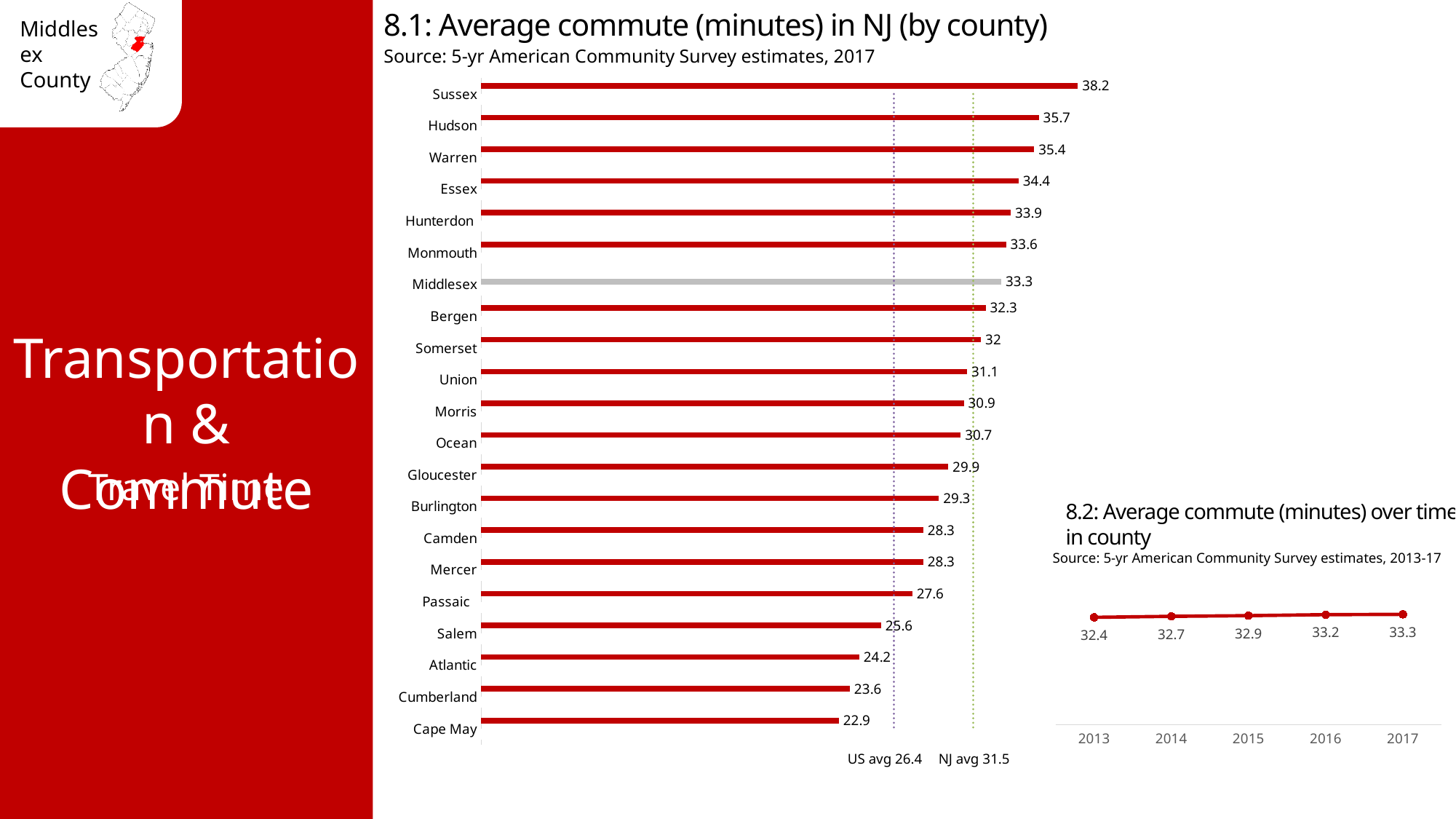
In chart 8.2, do the values rise or fall from 2013 to 2017? Rise In chart 8.1, which county has the lowest average commute? Cape May In chart 8.2, what is the difference between the 2017 and 2013 values? 0.9 In chart 8.1, which county has the highest average commute? Sussex What kind of chart is chart 8.1? Bar chart In chart 8.1 (Average commute in NJ by county), what is the average commute for Middlesex? 33.3 In chart 8.2, how many years are plotted? 5 In chart 8.1, what is the NJ average commute shown at the bottom of the chart? 31.5 In chart 8.1, what is the difference between the average commute for Sussex and Cape May? 15.3 In chart 8.1, which has a longer average commute, Hudson or Warren? Hudson In chart 8.2 (Average commute over time in county), what is the value for 2015? 32.9 In chart 8.1, how many counties are shown? 21